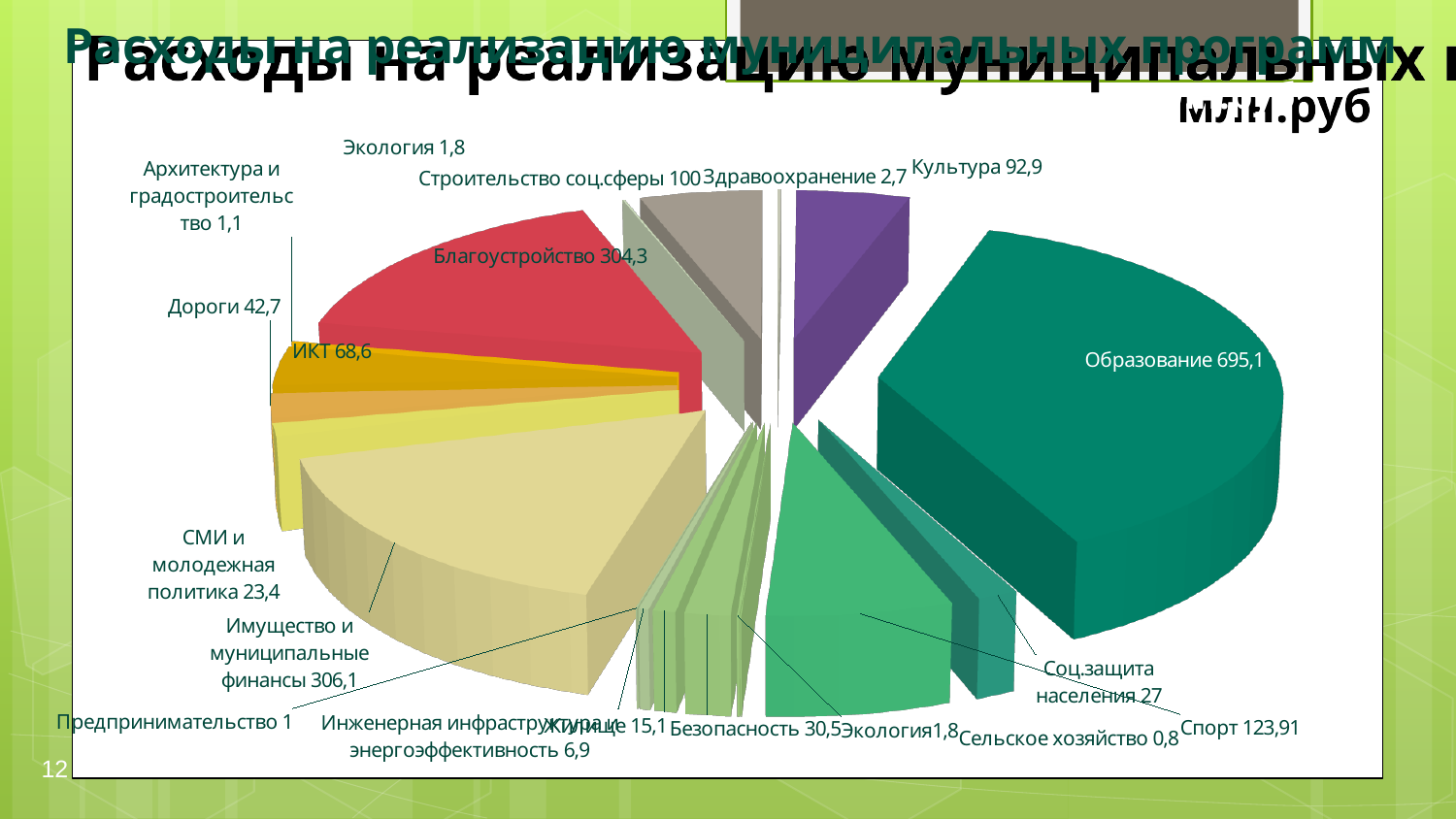
Which is larger, Имущество и муниципальные финансы or Благоустройство? Имущество и муниципальные финансы What is the value for Образование? 695,1 What is the value for Благоустройство? 304,3 Which category has the lowest value? Сельское хозяйство In what unit are the values on the chart given? млн.руб Which category has the highest value? Образование What is the value for Соц.защита населения? 27 What is the difference between Спорт and Строительство соц.сферы? 23,91 What is the value for Спорт? 123,91 What is the difference between Культура and ИКТ? 24,3 What is the value for ИКТ? 68,6 What kind of chart is shown on the slide? pie chart